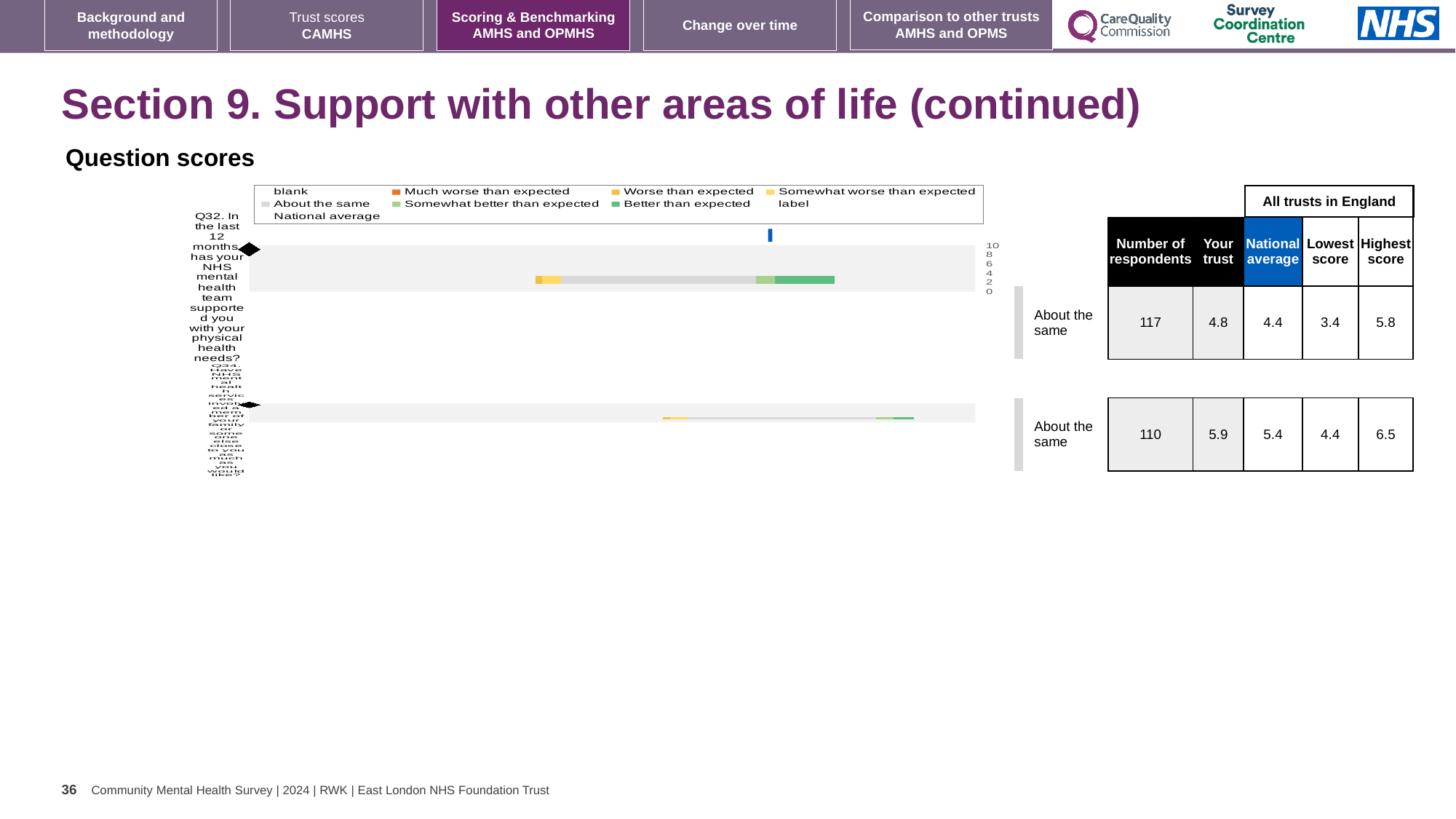
For Q34, what is the difference between the 'Your trust' score (5.9) and the national average (5.4)? 0.5 What benchmark category label is shown next to both Q32 and Q34 bars? About the same In the table beside the chart, how many respondents answered Q34? 110 What kind of chart is shown under 'Question scores'? bar chart What is the highest tick value shown on the chart's axis? 10 Which legend entry is shown in orange? Much worse than expected In the table beside the chart, what is the 'Your trust' score for Q32 (support with physical health needs)? 4.8 For Q32, which is larger: the 'Your trust' score or the national average? Your trust In the table beside the chart, what is the 'Your trust' score for Q34 (involving family or someone close)? 5.9 How many survey questions (bars) are plotted in the chart? 2 Which question had more respondents, Q32 or Q34? Q32 In the table beside the chart, what is the national average for Q32? 4.4